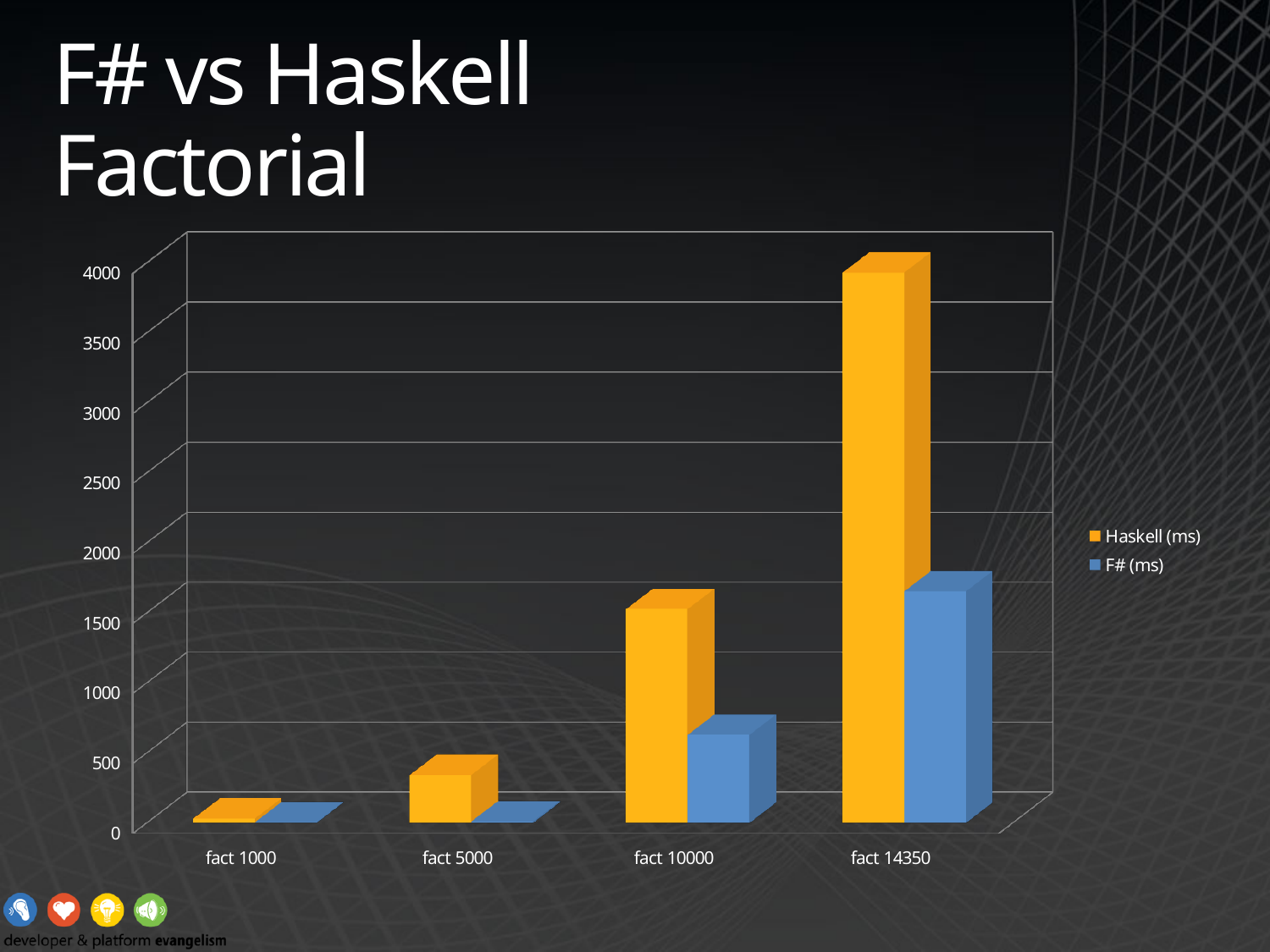
Which category has the highest Haskell (ms) value? fact 14350 For fact 14350, which series has the larger value, Haskell (ms) or F# (ms)? Haskell (ms) What kind of chart is shown on the slide? bar chart How many series does the legend list? 2 Do the Haskell (ms) values rise or fall from fact 1000 to fact 14350? rise Is the Haskell (ms) value for fact 10000 greater or less than 1000? greater For fact 10000, which series has the larger value, Haskell (ms) or F# (ms)? Haskell (ms) Which category has the lowest Haskell (ms) value? fact 1000 Which colour represents the Haskell (ms) series in the legend? orange How many categories are shown on the x axis? 4 Is the Haskell (ms) value for fact 14350 greater or less than 3500? greater Is the F# (ms) value for fact 10000 greater or less than 1000? less